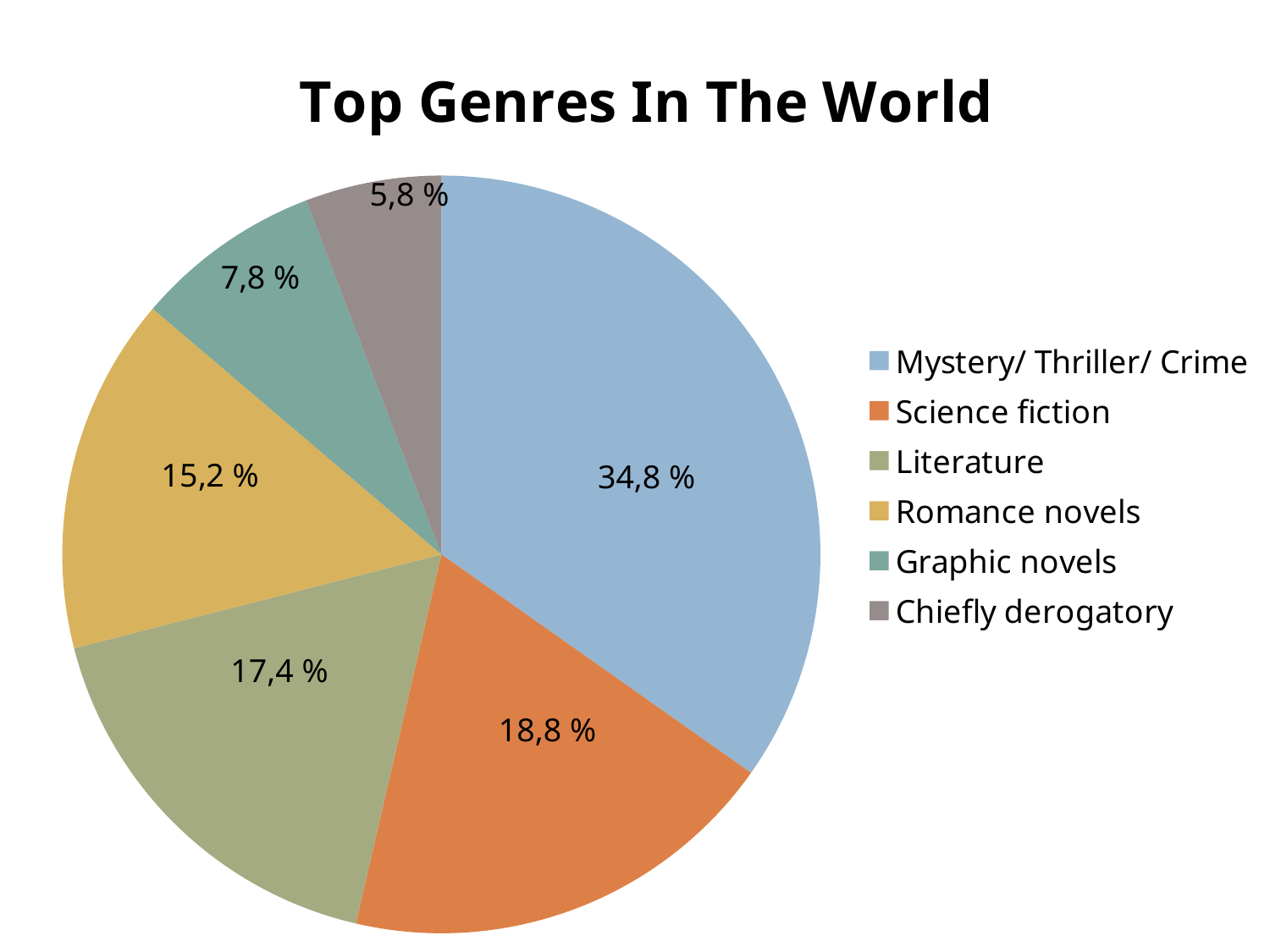
What is the value shown for Literature? 17,4 % How many genres are shown in the pie chart? 6 What kind of chart is shown on the slide? pie chart What is the difference between the values for Science fiction and Literature? 1,4 % Which genre has the largest slice of the pie? Mystery/ Thriller/ Crime What share of the pie does Mystery/ Thriller/ Crime have? 34,8 % What is the title of the chart? Top Genres In The World What is the value shown for Romance novels? 15,2 % What is the value shown for Science fiction? 18,8 % Which is larger, the value for Romance novels or the value for Graphic novels? Romance novels Which genre has the smallest slice of the pie? Chiefly derogatory What is the value shown for Graphic novels? 7,8 %